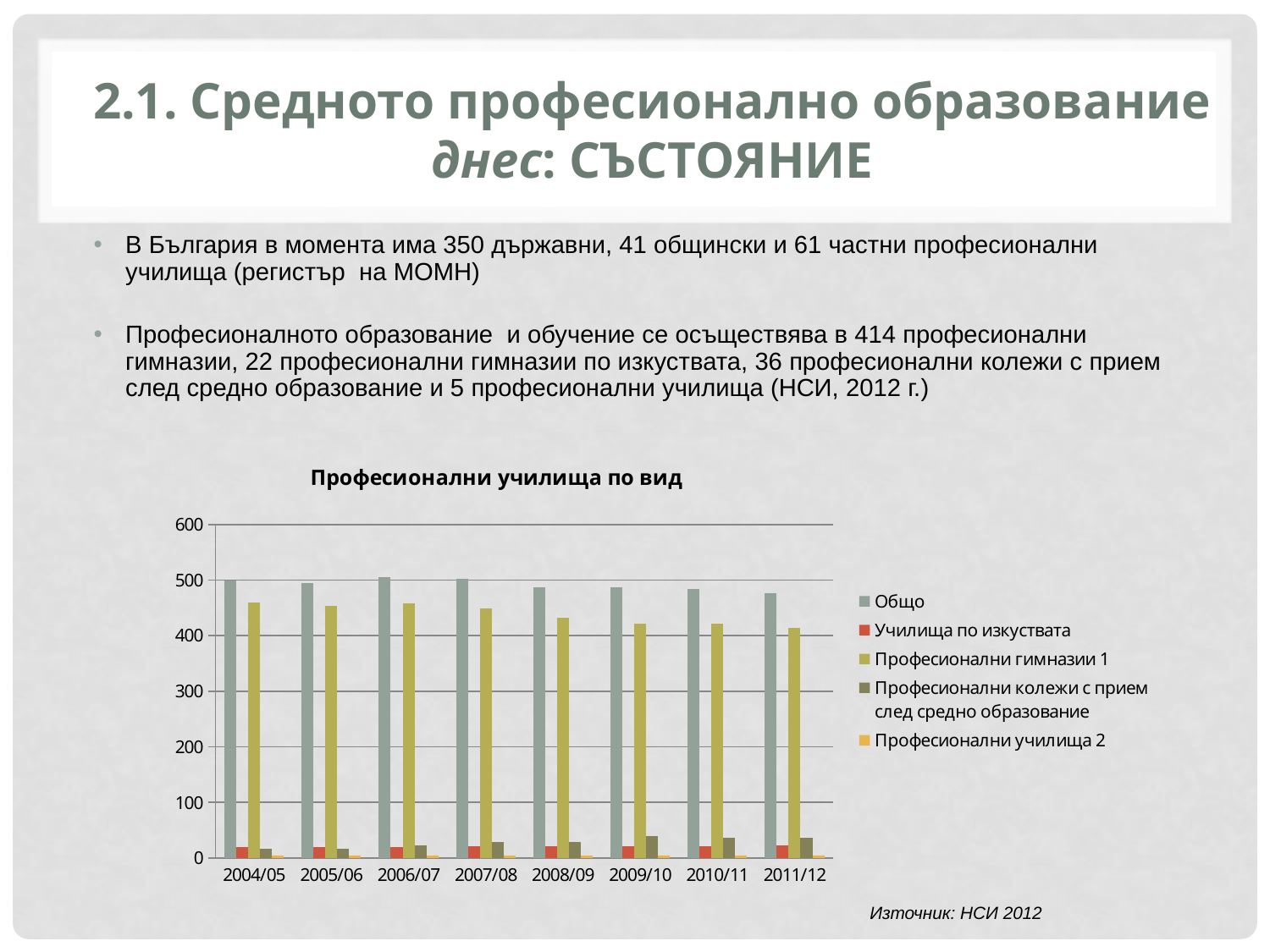
Is the value for Общо in 2011/12 greater or less than 500? less Do the values for Професионални гимназии 1 generally rise or fall from 2004/05 to 2011/12? fall Is the value for Общо in 2004/05 greater or less than 400? greater What is the title of the chart? Професионални училища по вид Which series has the shortest bars in the chart? Професионални училища 2 Which series has the tallest bars in every year of the chart? Общо How many school years are shown on the x axis of the chart? 8 How many series does the chart's legend list? 5 What kind of chart is shown on the slide? bar chart Is the value for Училища по изкуствата in 2004/05 greater or less than 100? less In 2008/09, which is larger: Общо or Професионални гимназии 1? Общо